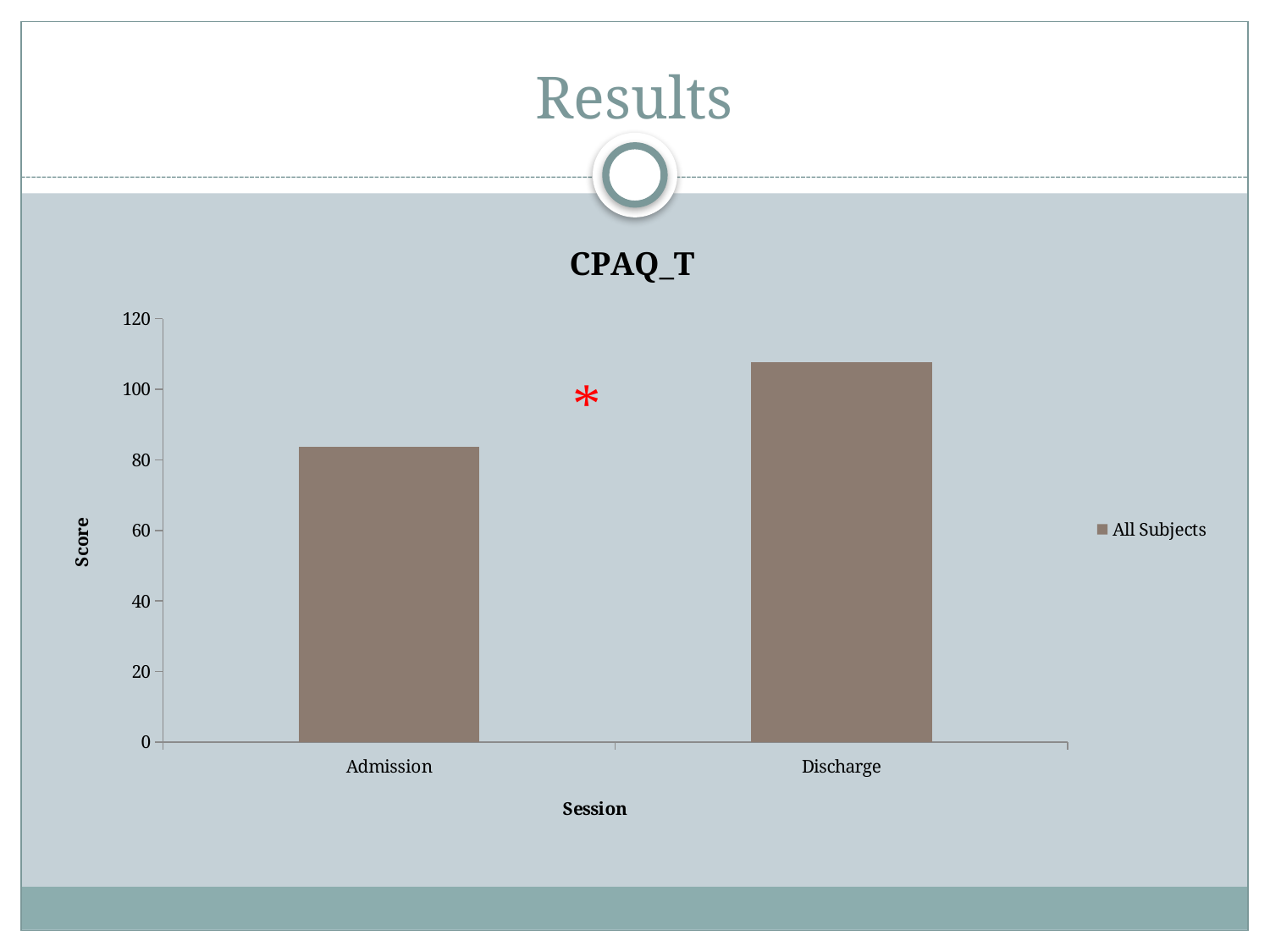
Is the score for Admission greater or less than 80? greater What is the name of the series in the legend? All Subjects What is the title of the chart? CPAQ_T How many categories are shown on the x axis? 2 What kind of chart is shown on the slide? bar chart Which session has the lowest score? Admission Which session has the highest score? Discharge Is the score for Discharge greater or less than 100? greater How many series does the legend list? 1 Is the score for Admission greater or less than 100? less Which is larger, the score at Admission or at Discharge? Discharge Do the scores rise or fall from Admission to Discharge? rise